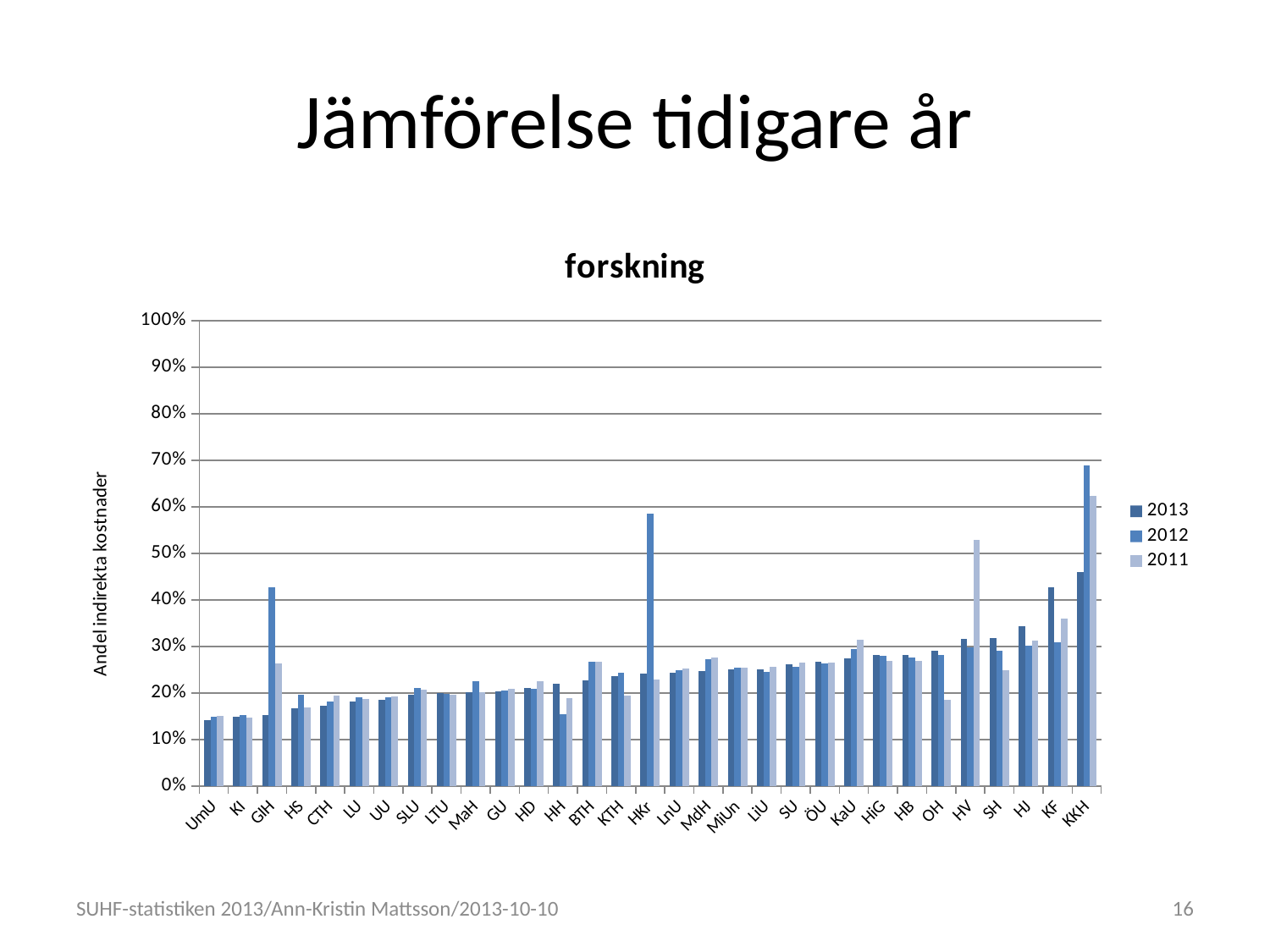
Do the 2013 values generally rise or fall from left to right along the x axis? rise What kind of chart is shown on the slide? bar chart How many series does the legend list? 3 What is the label on the vertical axis? Andel indirekta kostnader Which category has the highest 2012 value? KKH Is the 2012 value for HKr greater or less than 50%? greater Is the 2013 value for UmU greater or less than 20%? less For KKH, which is larger: the 2012 value or the 2013 value? 2012 What is the title of the chart? forskning Is the 2012 value for GIH greater or less than 40%? greater How many categories are shown on the x axis? 31